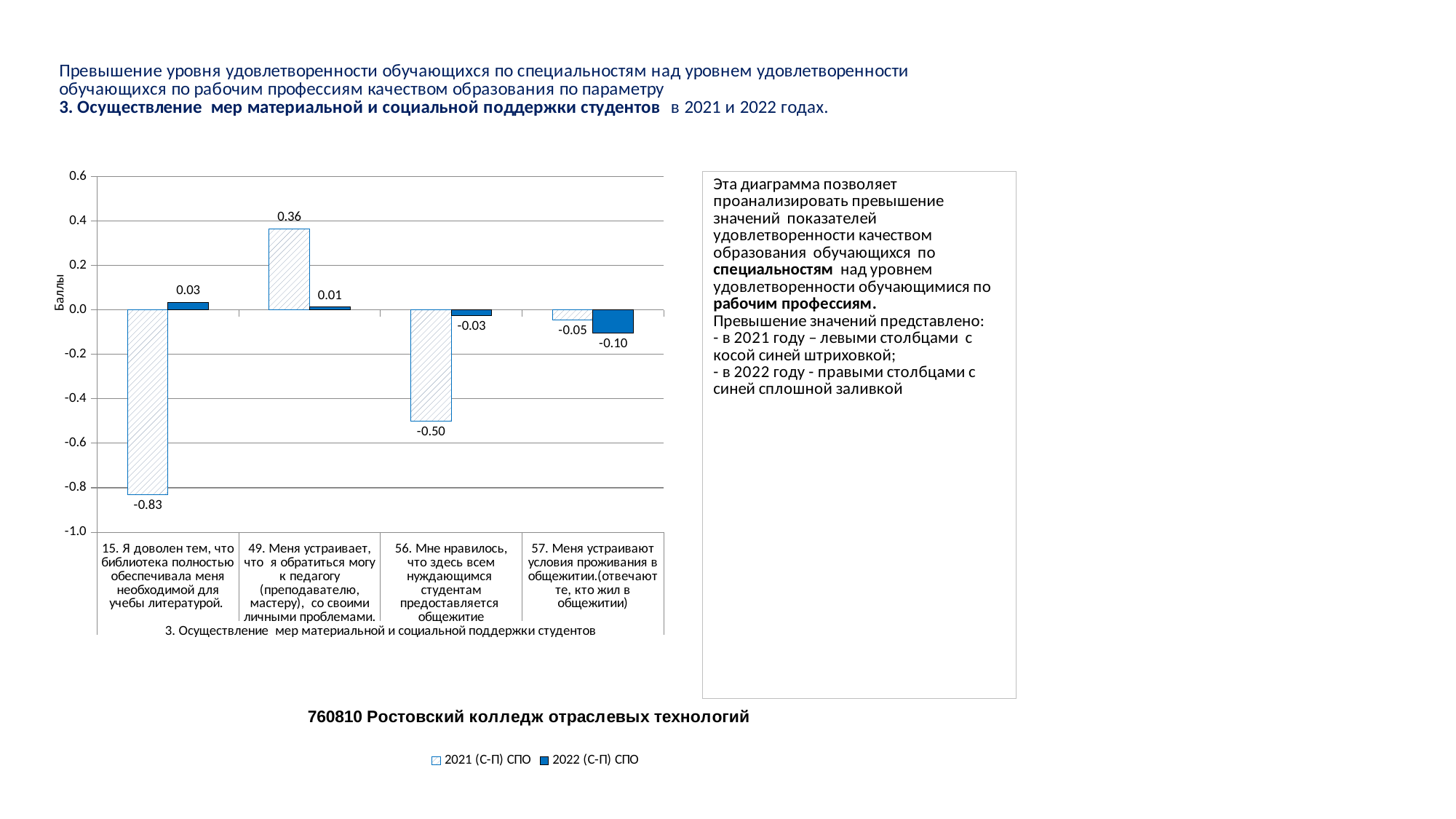
What is the value of the 2022 (С-П) СПО series for category 49 (can approach a teacher with personal problems)? 0.01 What is the difference between the 2021 and 2022 values for category 49? 0.35 How many categories are shown on the x axis of the chart? 4 For category 57, which series has the larger value, 2021 (С-П) СПО or 2022 (С-П) СПО? 2021 (С-П) СПО What type of chart is shown on the slide? bar chart What is the value of the 2022 (С-П) СПО series for category 57 (living conditions in the dormitory)? -0.10 What is the value of the 2021 (С-П) СПО series for category 15 (library provided necessary literature)? -0.83 Which category has the lowest value in the 2021 (С-П) СПО series? 15. Я доволен тем, что библиотека полностью обеспечивала меня необходимой для учебы литературой. How many series does the legend list? 2 What is the label of the vertical axis of the chart? Баллы What is the value of the 2021 (С-П) СПО series for category 56 (dormitory provided to all students in need)? -0.50 Which category has the highest value in the 2021 (С-П) СПО series? 49. Меня устраивает, что я обратиться могу к педагогу (преподавателю, мастеру), со своими личными проблемами.